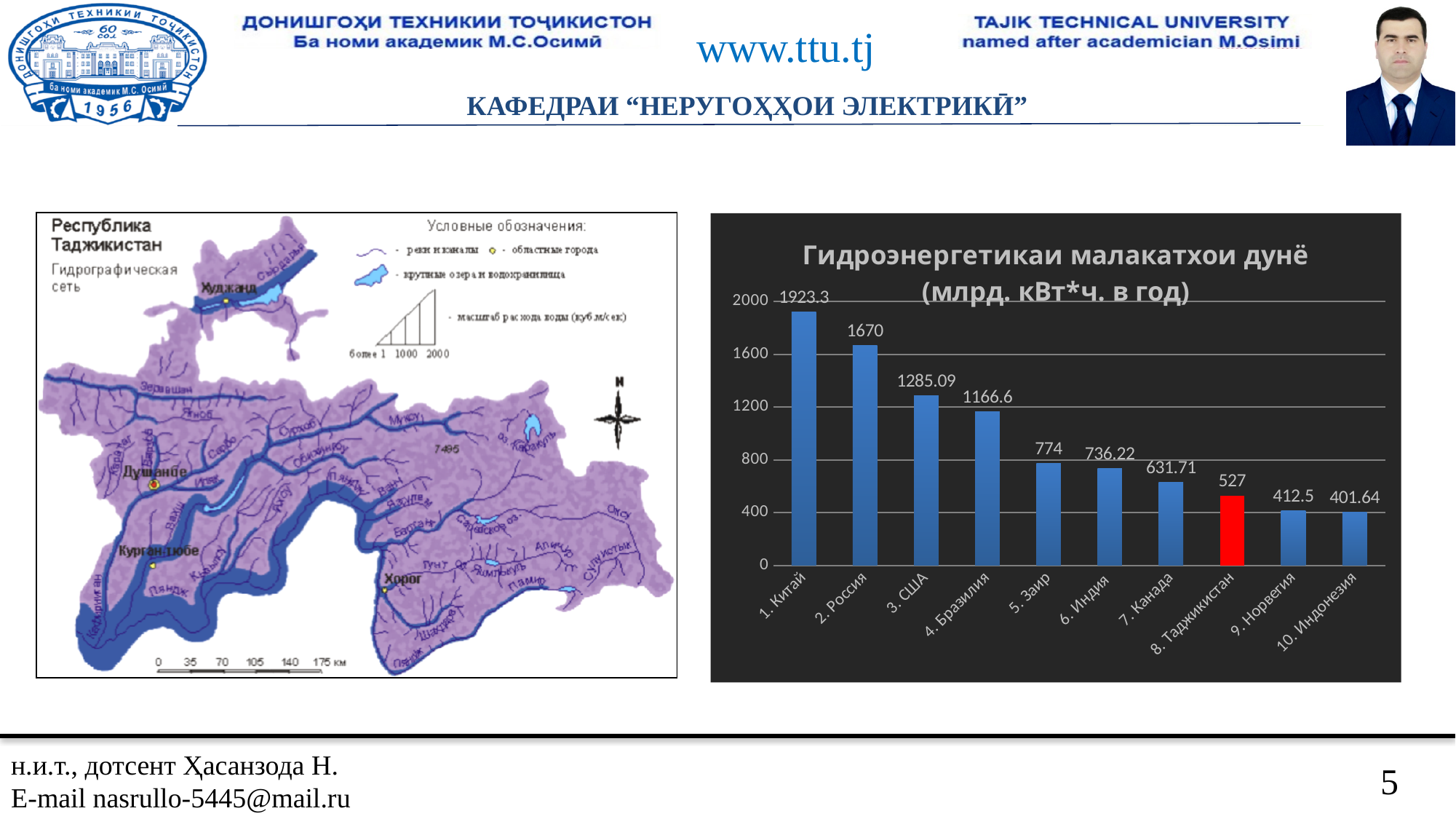
What is the value for 3. США in the chart? 1285.09 Which category has the highest value in the chart? 1. Китай Do the values rise or fall from left to right along the x axis? fall What type of chart is shown on the slide? bar chart What is the difference between the values for 2. Россия and 8. Таджикистан? 1143 Which is larger, the value for 5. Заир or the value for 6. Индия? 5. Заир What is the value for 1. Китай in the chart? 1923.3 Which bar in the chart is coloured red? 8. Таджикистан What is the value for 8. Таджикистан in the chart? 527 Is the value for 7. Канада greater or less than 800? less Which category has the lowest value in the chart? 10. Индонезия How many categories are shown in the chart? 10